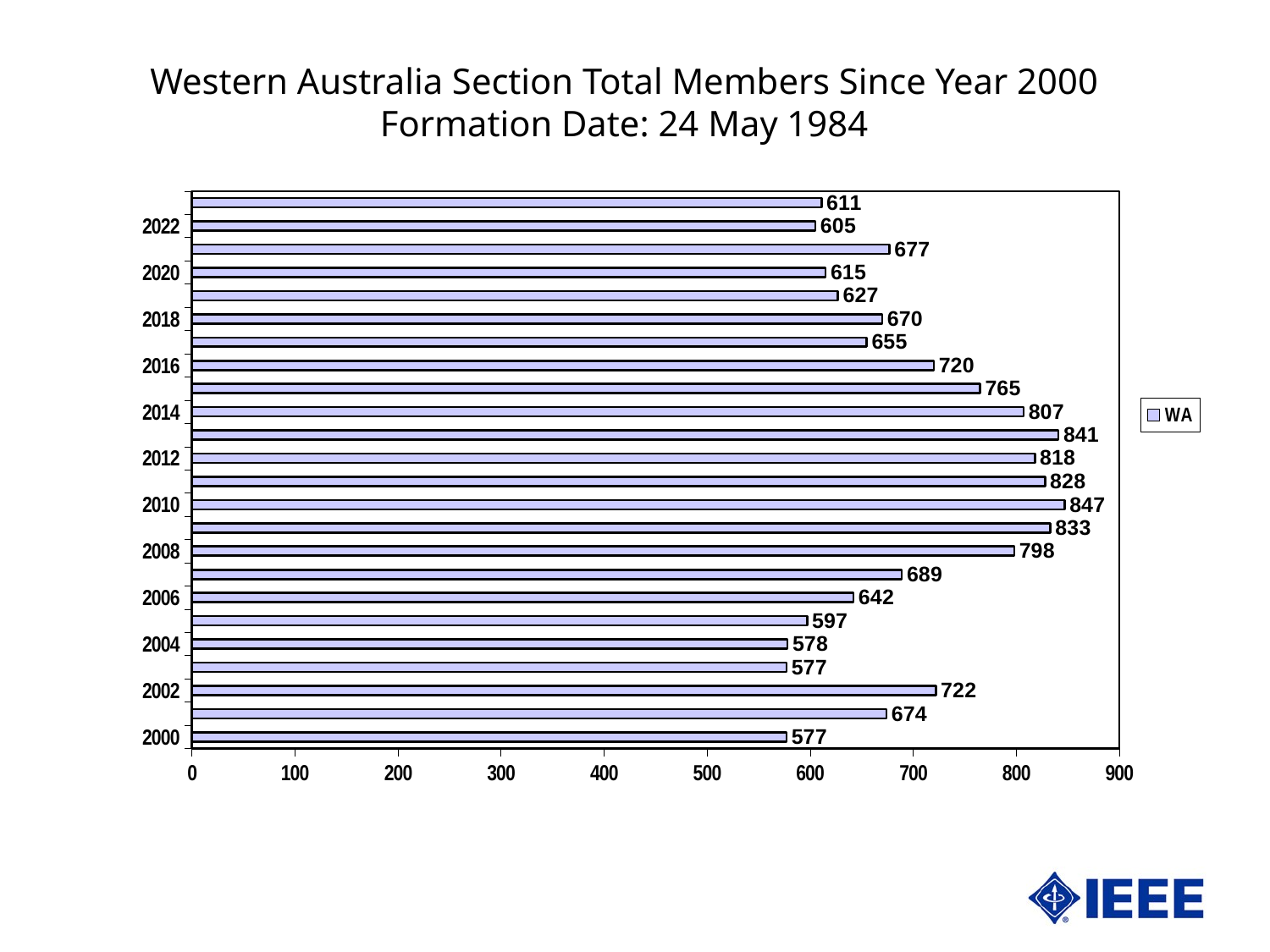
What is the value for 2016? 720 What is the difference between the values for 2010 and 2000? 270 Which is larger, the value for 2002 or the value for 2018? 2002 What is the difference between the values for 2014 and 2020? 192 What is the value for 2010? 847 How many bars are plotted in the chart? 24 How many series does the legend list? 1 Which year has the highest value? 2010 What is the value for 2000? 577 Is the value for 2008 greater or less than 700? greater What is the value for 2022? 605 What kind of chart is shown on the slide? bar chart